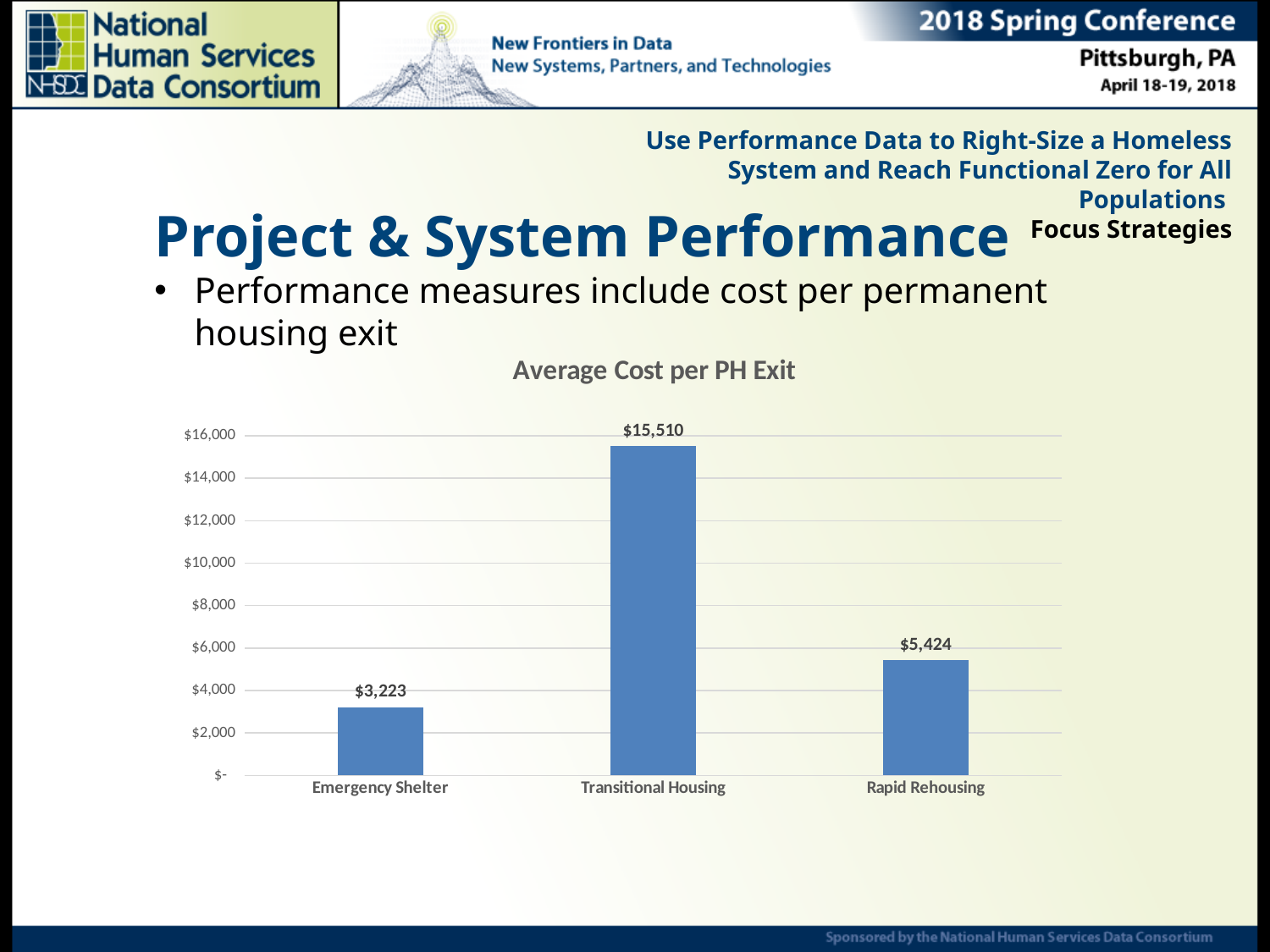
What is the difference in average cost per PH exit between Rapid Rehousing and Emergency Shelter? $2,201 Which has a higher average cost per PH exit, Rapid Rehousing or Emergency Shelter? Rapid Rehousing What is the average cost per PH exit for Rapid Rehousing? $5,424 What is the average cost per PH exit for Transitional Housing? $15,510 Which project type has the highest average cost per PH exit? Transitional Housing What kind of chart is used to show average cost per PH exit? Bar chart What is the title of the chart? Average Cost per PH Exit Which project type has the lowest average cost per PH exit? Emergency Shelter How many project types are shown in the chart? 3 What is the difference in average cost per PH exit between Transitional Housing and Rapid Rehousing? $10,086 What is the average cost per PH exit for Emergency Shelter? $3,223 Is the average cost per PH exit for Transitional Housing greater or less than $14,000? greater